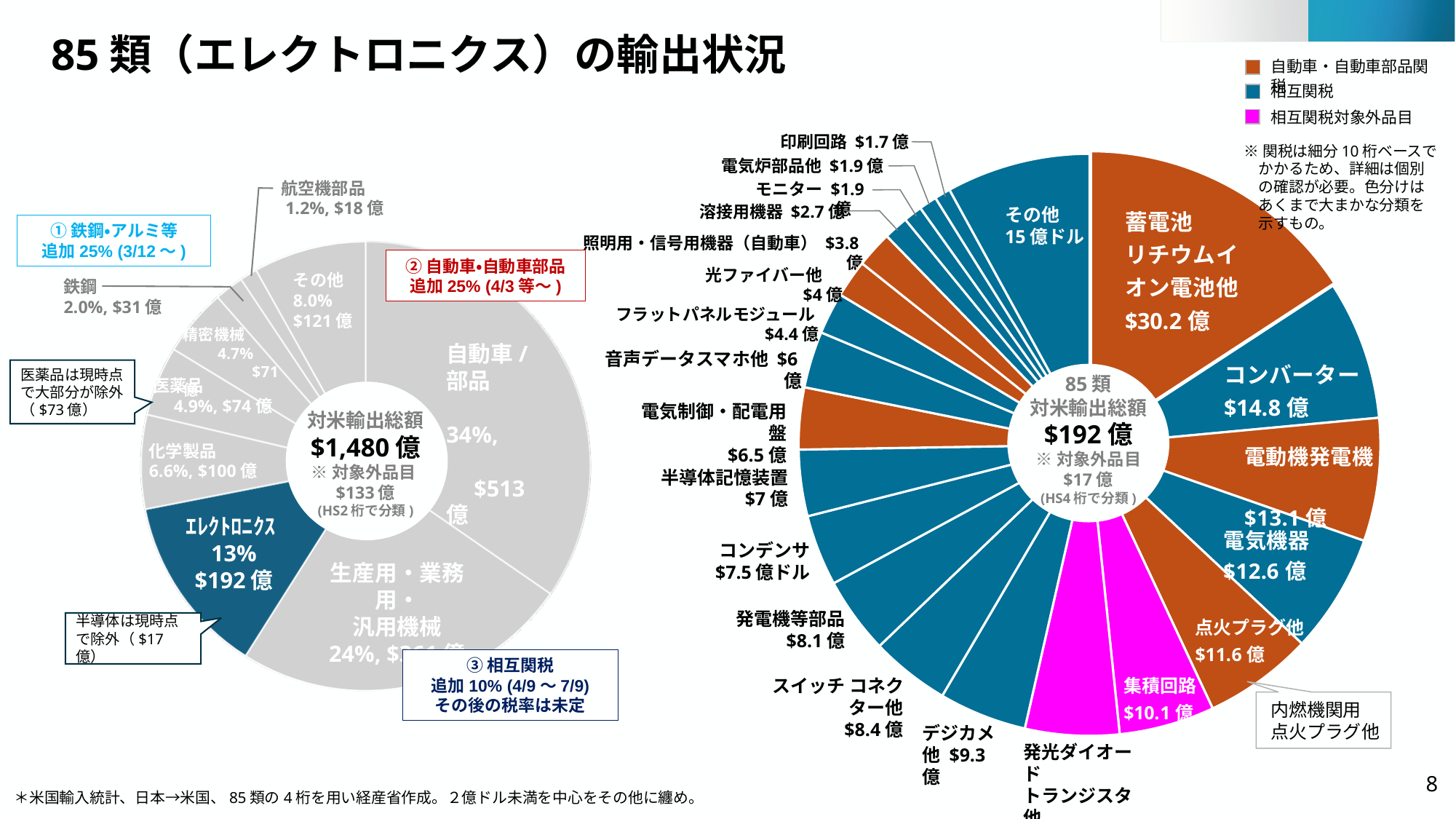
In the left donut chart, which labeled category has the smallest share? 航空機部品 What type of chart is used on this slide? Pie (donut) chart How many entries does the legend in the top right list? 3 In the left donut chart, what is the total export value to the US shown in the center? $1,480 億 In the left donut chart, what is the value shown for 化学製品? 6.6%, $100 億 In the right donut chart (85 類), what is the difference between コンバーター ($14.8 億) and 電動機発電機 ($13.1 億)? $1.7 億 In the left donut chart, what share and value are shown for エレクトロニクス? 13%, $192 億 In the right donut chart (85 類), what is the value for 蓄電池 リチウムイオン電池他? $30.2 億 In the right donut chart (85 類), which is larger: 点火プラグ他 or デジカメ他? 点火プラグ他 In the right donut chart (85 類), which segment has the largest value? 蓄電池 リチウムイオン電池他 In the right donut chart (85 類), what is the value for 集積回路? $10.1 億 In the left donut chart, which category has the largest share? 自動車 / 部品